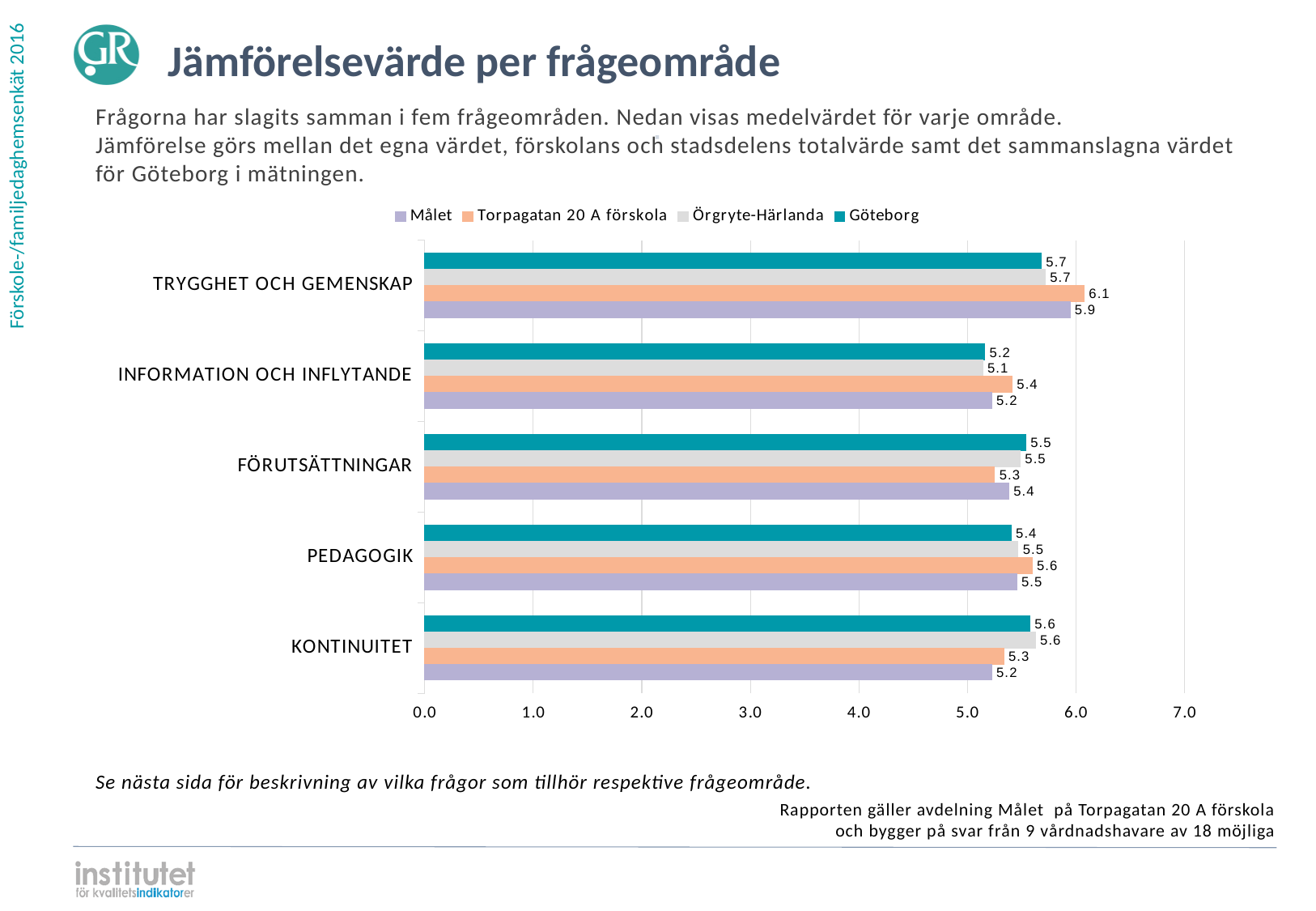
How many question areas (categories) are shown on the chart? 5 What is the value for Örgryte-Härlanda in the PEDAGOGIK category? 5.5 In which category does Målet have its lowest value? INFORMATION OCH INFLYTANDE and KONTINUITET (both 5.2) Which series is shown in orange in the legend? Torpagatan 20 A förskola What is the value for Målet in the TRYGGHET OCH GEMENSKAP category? 5.9 What is the value for Göteborg in the KONTINUITET category? 5.6 In which category does Torpagatan 20 A förskola have its highest value? TRYGGHET OCH GEMENSKAP How many series does the legend list? 4 What is the difference between the Torpagatan 20 A förskola value and the Målet value in the KONTINUITET category? 0.1 In the FÖRUTSÄTTNINGAR category, which is larger: the value for Göteborg or the value for Torpagatan 20 A förskola? Göteborg What is the value for Torpagatan 20 A förskola in the INFORMATION OCH INFLYTANDE category? 5.4 What kind of chart is shown on the slide? Bar chart